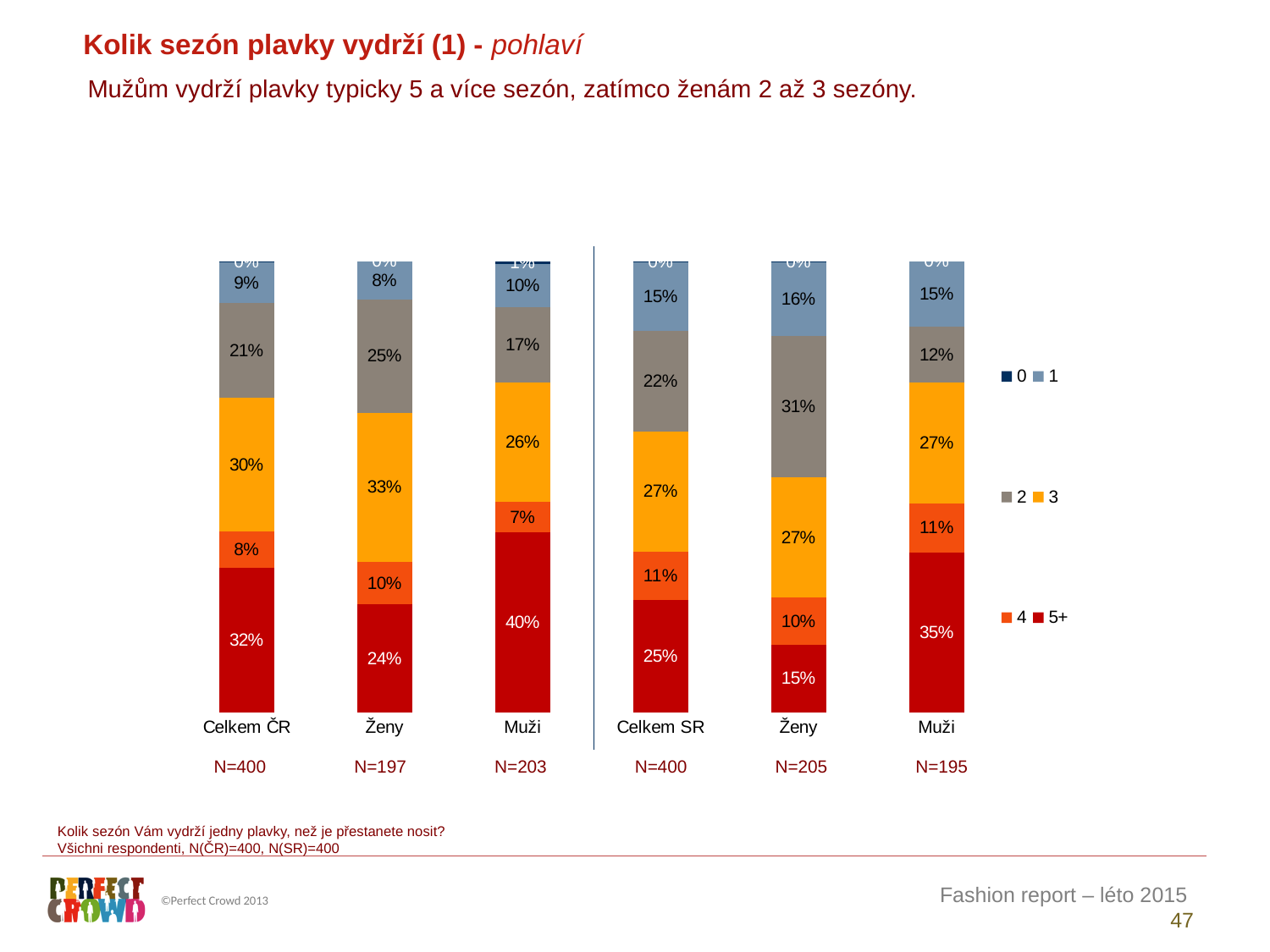
How many bars are shown in the chart? 6 What is the value of the '4' segment for Celkem ČR? 8% Which bar has the lowest value for the '5+' segment? Ženy (SR) What is the sample size (N) shown under Muži in the SR group? N=195 What type of chart is shown on the slide? Stacked bar chart What is the value of the '2' segment for Ženy in the SR group? 31% Which bar has the highest value for the '5+' segment? Muži (ČR) What is the value of the '1' segment for Celkem SR? 15% In the ČR group, which has a larger '3' segment, Ženy or Muži? Ženy How many series does the legend list? 6 What percentage of Muži in the ČR group say their swimsuit lasts 5+ seasons? 40% What is the difference between the '5+' values for Muži and Ženy in the ČR group? 16 percentage points